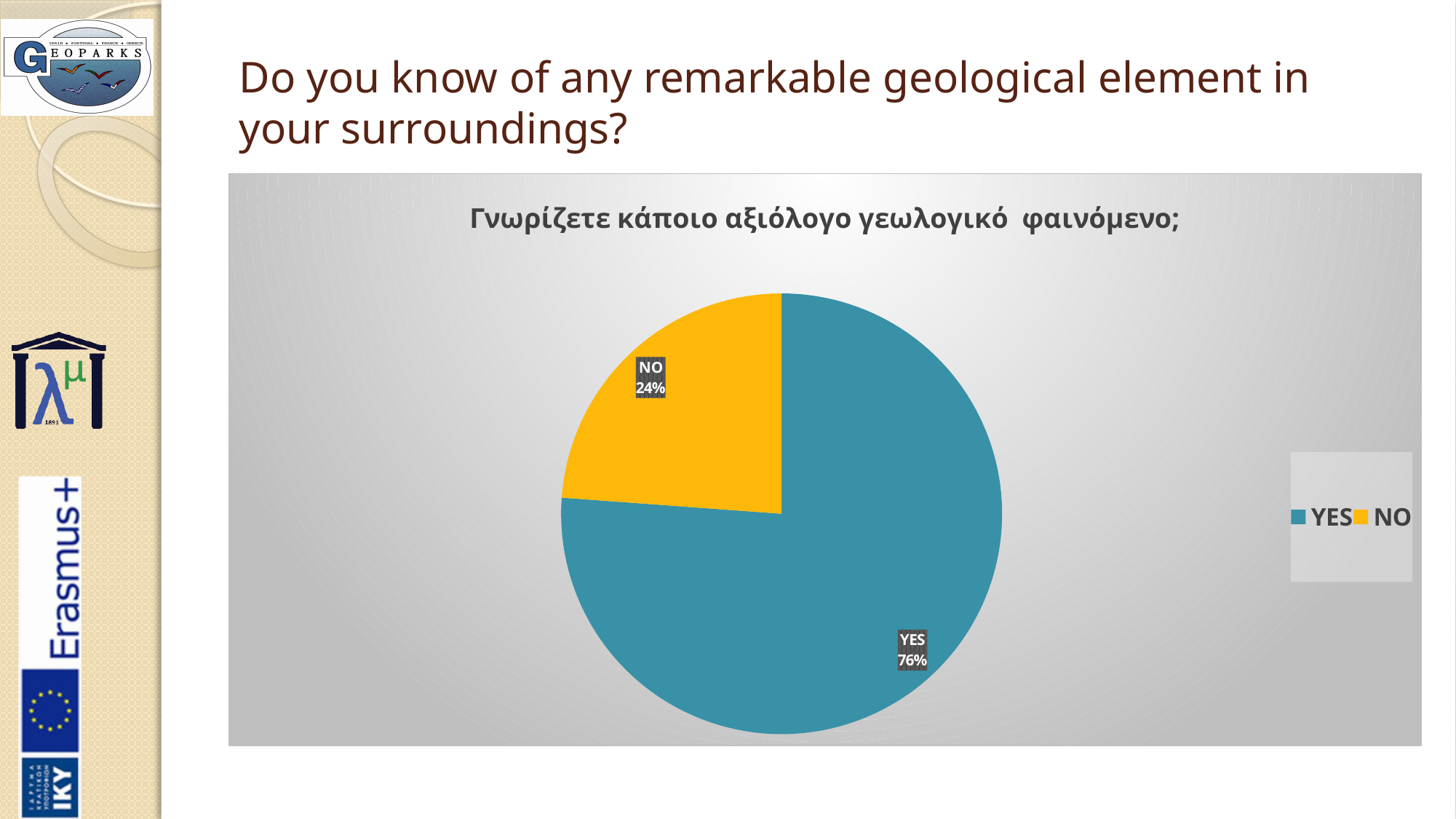
What kind of chart is shown on the slide? pie chart What colour is the YES slice? teal blue Which is larger, the YES share or the NO share? YES What colour is the NO slice? yellow Which response has the largest share of the pie? YES What percentage of respondents answered NO? 24% How many slices does the pie chart have? 2 Is the YES share greater or less than 50%? greater How many entries does the legend list? 2 What percentage of respondents answered YES? 76% What is the difference in percentage points between the YES and NO shares? 52 Which response has the smallest share of the pie? NO